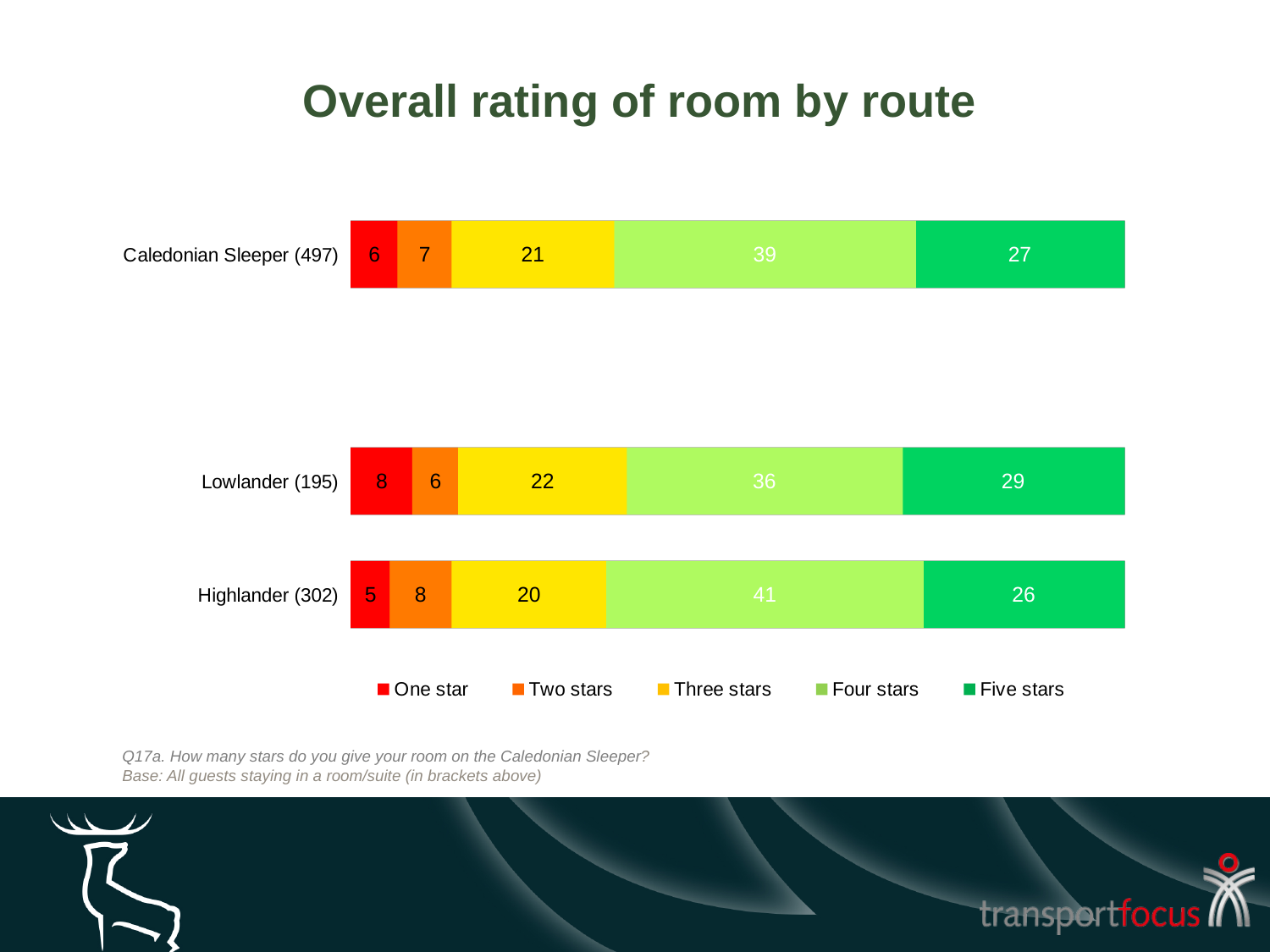
How many routes are shown in the chart? 3 Which is larger: the Three stars value for Lowlander (195) or for Highlander (302)? Lowlander (195) How many series does the legend list? 5 What is the total of the stacked bar for Caledonian Sleeper (497)? 100 What is the One star value for Caledonian Sleeper (497)? 6 What is the title of the chart? Overall rating of room by route What is the Four stars value for Highlander (302)? 41 Which route has the highest Four stars value? Highlander (302) What kind of chart is shown on the slide? Stacked bar chart What is the Five stars value for Lowlander (195)? 29 What is the difference between the Four stars values for Highlander (302) and Lowlander (195)? 5 Which route has the lowest One star value? Highlander (302)